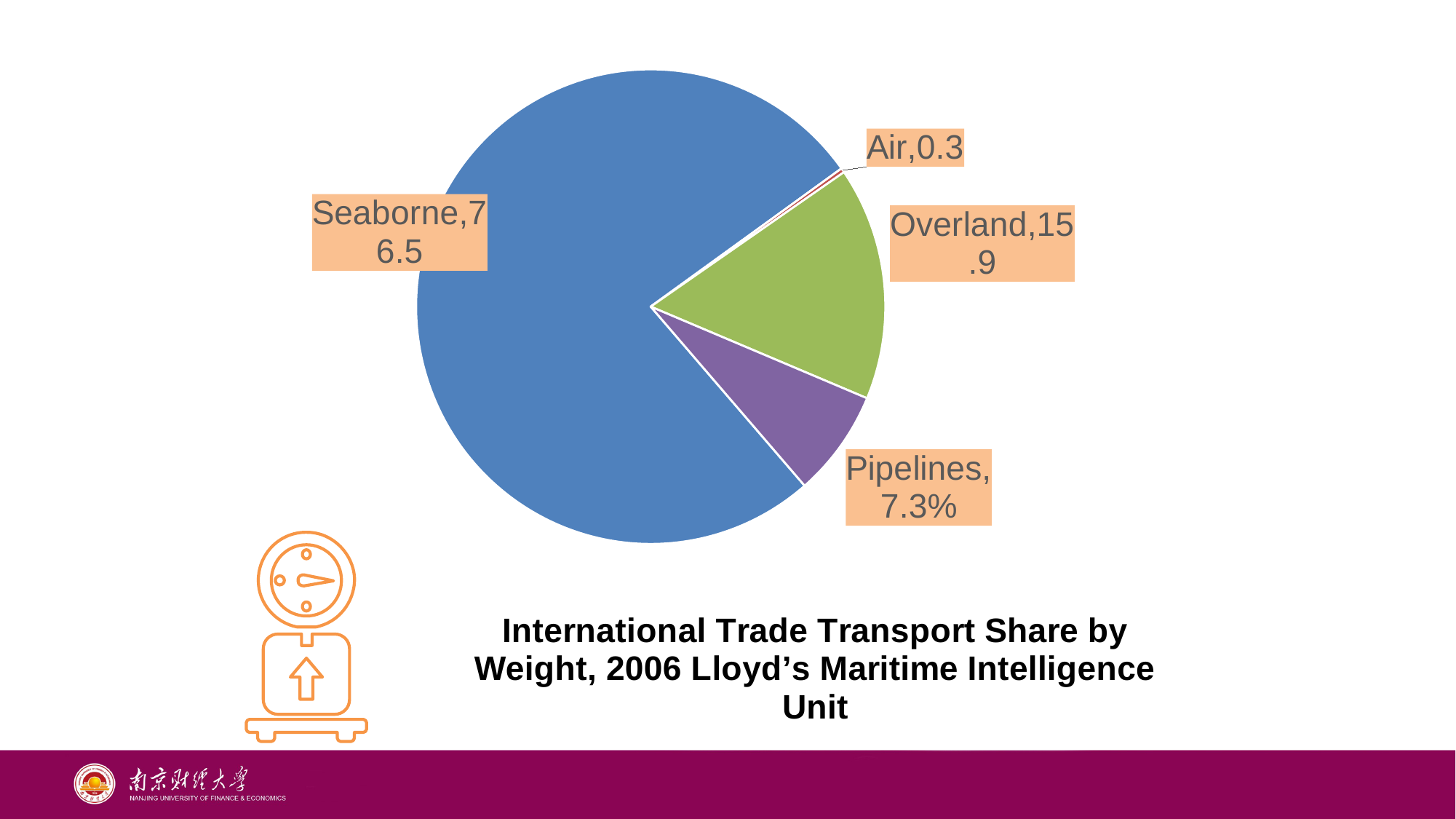
Which transport mode has the largest slice of the pie chart? Seaborne How many slices does the pie chart have? 4 Which transport mode has the smallest slice of the pie chart? Air What kind of chart is shown on the slide? Pie chart What is the value shown for Seaborne in the pie chart? 76.5 What is the difference between the Seaborne and Overland values? 60.6 Which is larger, the Overland value or the Pipelines value? Overland What is the value shown for Air in the pie chart? 0.3 What is the value shown for Overland in the pie chart? 15.9 What colour is the Seaborne slice of the pie chart? Blue What is the title of the chart? International Trade Transport Share by Weight, 2006 Lloyd's Maritime Intelligence Unit What is the value shown for Pipelines in the pie chart? 7.3%